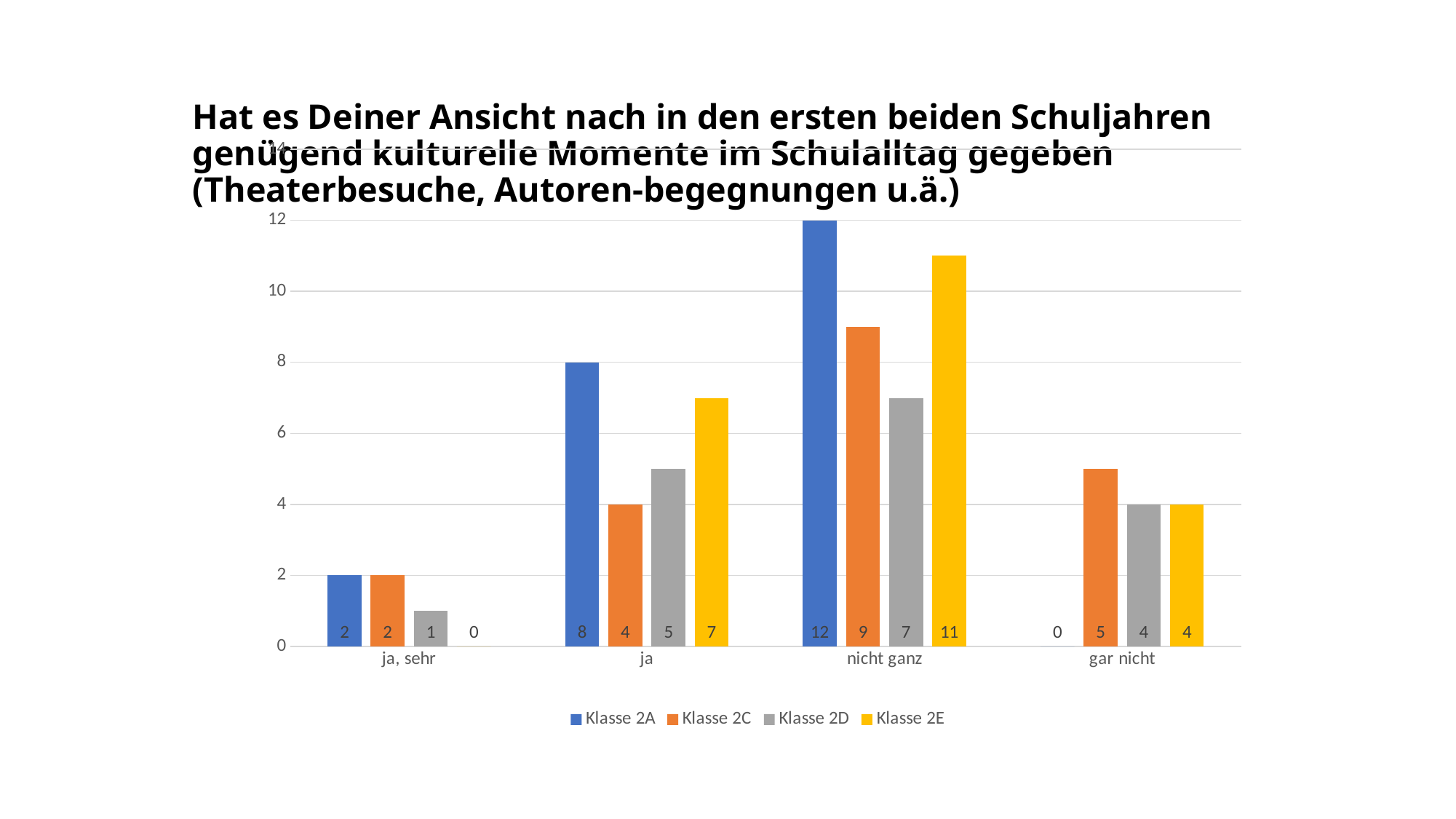
How many series does the legend list? 4 Which class has the lowest value for "ja"? Klasse 2C What value does Klasse 2A have for "nicht ganz"? 12 What value does Klasse 2C have for "gar nicht"? 5 Which class has the highest value for "nicht ganz"? Klasse 2A What is the difference between Klasse 2A and Klasse 2C for "ja"? 4 What value does Klasse 2D have for "ja, sehr"? 1 Which colour represents Klasse 2E in the chart? Yellow What kind of chart is shown on the slide? Bar chart How many answer categories are shown on the x axis? 4 Which is larger: Klasse 2E for "nicht ganz" or Klasse 2C for "nicht ganz"? Klasse 2E What value does Klasse 2E have for "ja"? 7